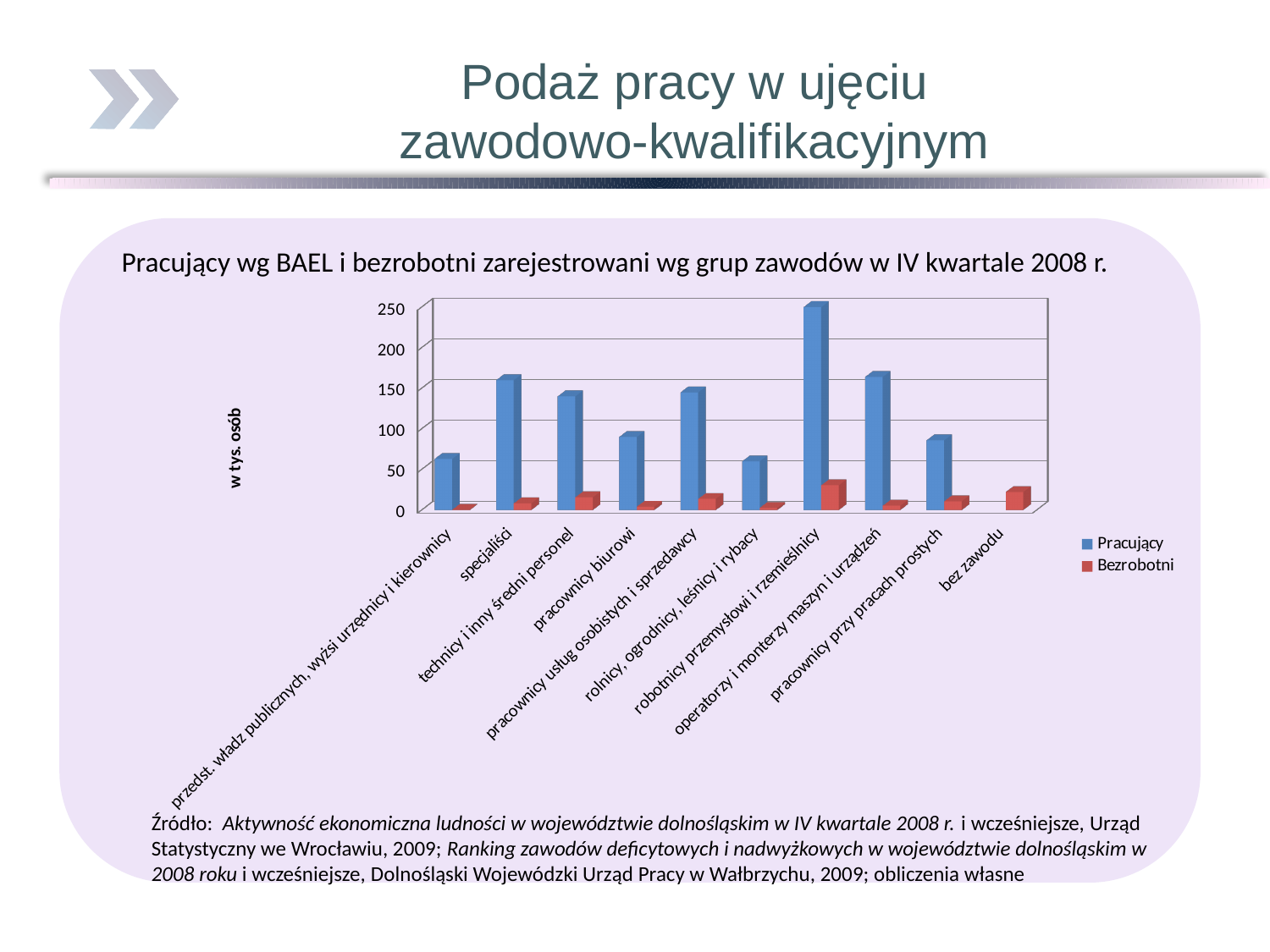
What type of chart is shown on the slide? bar chart Is the Pracujący value for rolnicy, ogrodnicy, leśnicy i rybacy greater or less than 100? less What is the title of the chart? Pracujący wg BAEL i bezrobotni zarejestrowani wg grup zawodów w IV kwartale 2008 r. Is the Pracujący value for specjaliści greater or less than 100? greater How many occupational groups (categories) are shown on the x axis? 10 Which is larger: the Pracujący value for specjaliści or for pracownicy biurowi? specjaliści Is the Pracujący value for robotnicy przemysłowi i rzemieślnicy greater or less than 200? greater Which occupational group has the highest value for Pracujący? robotnicy przemysłowi i rzemieślnicy How many series does the legend list? 2 What is the label of the vertical axis? w tys. osób